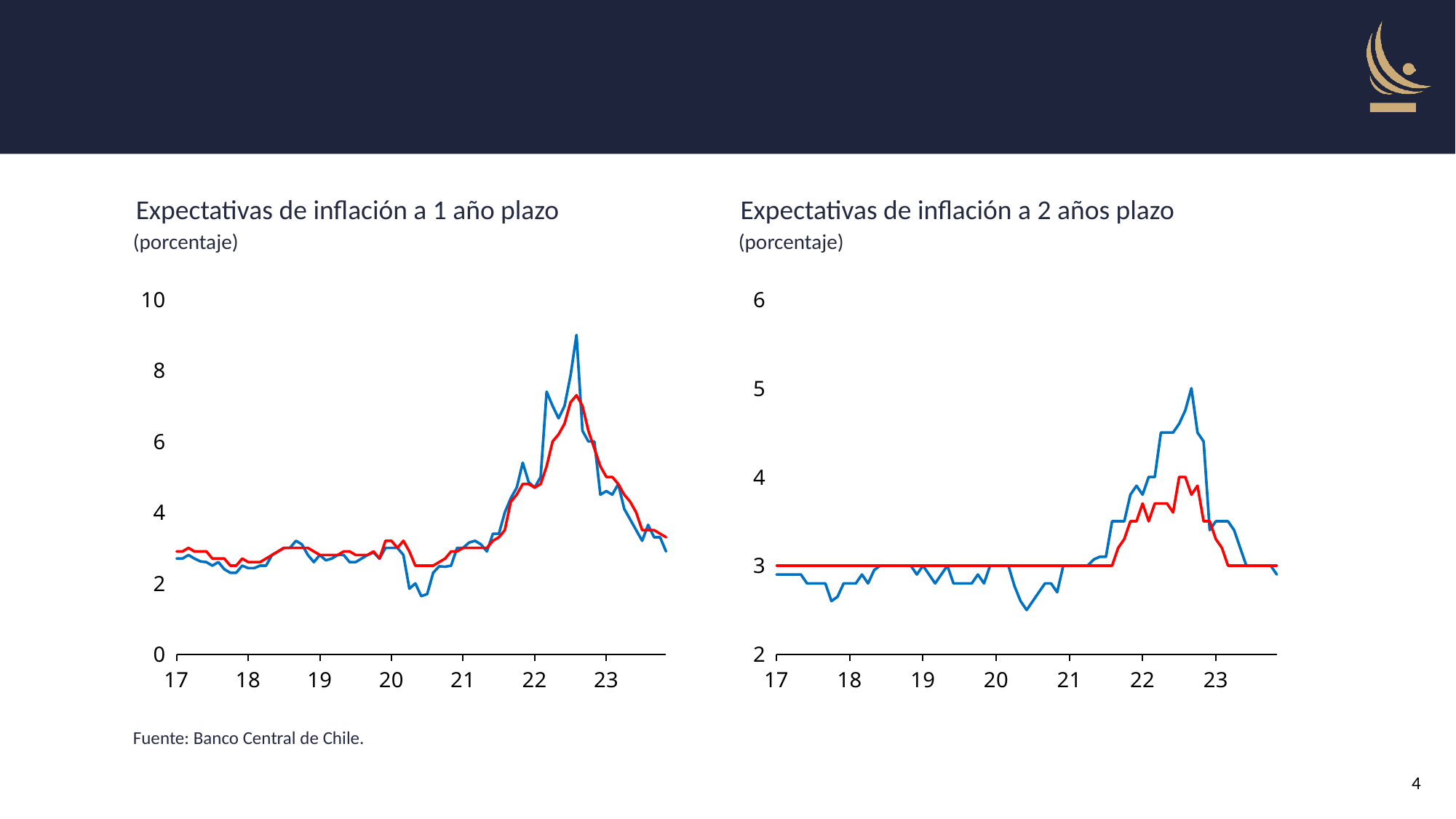
On the right chart, 'Expectativas de inflación a 2 años plazo', does the blue line rise or fall between 2021 and 2022? rise What is the highest value shown on the y axis of the left chart, 'Expectativas de inflación a 1 año plazo'? 10 On the left chart, 'Expectativas de inflación a 1 año plazo', which line reaches the higher peak around 2022, the blue or the red? blue What kind of chart is the left chart, 'Expectativas de inflación a 1 año plazo'? line chart How many year labels are shown on the x axis of the right chart, 'Expectativas de inflación a 2 años plazo'? 7 On the left chart, 'Expectativas de inflación a 1 año plazo', is the peak value of the red line greater or less than 8? less How many lines are plotted on the left chart, 'Expectativas de inflación a 1 año plazo'? 2 On the left chart, 'Expectativas de inflación a 1 año plazo', do the lines rise or fall from their 2022 peak to the end of 2023? fall What kind of chart is the right chart, 'Expectativas de inflación a 2 años plazo'? line chart On the left chart, 'Expectativas de inflación a 1 año plazo', is the peak value of the blue line greater or less than 8? greater On the right chart, 'Expectativas de inflación a 2 años plazo', at what value does the red line stay flat from 2017 until 2021? 3 On the right chart, 'Expectativas de inflación a 2 años plazo', is the peak value of the blue line greater or less than 4? greater